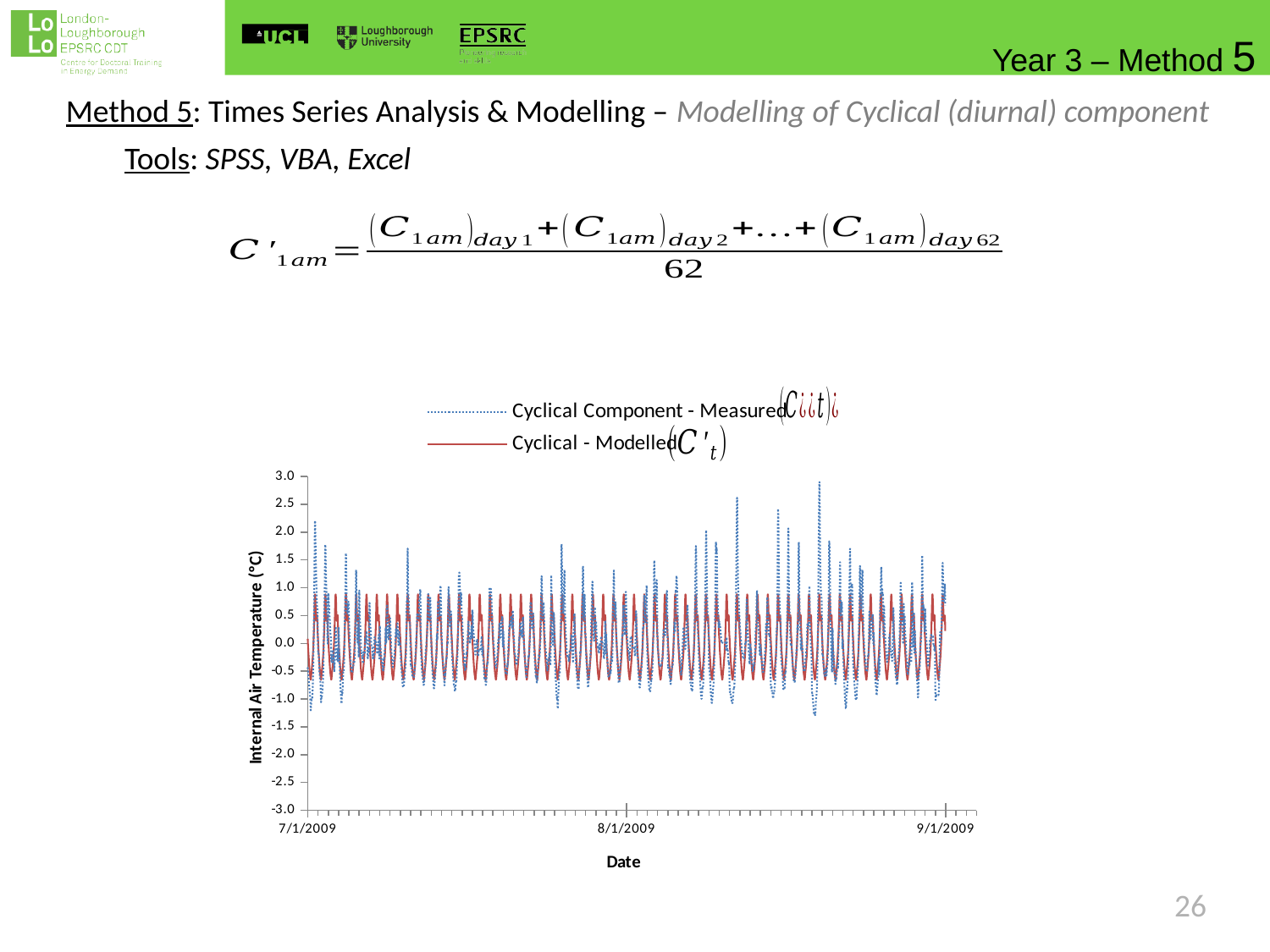
What is the first date labelled on the chart's horizontal axis? 7/1/2009 Which series in the chart is drawn as a dotted blue line? Cyclical Component - Measured What is the highest value shown on the chart's vertical axis? 3.0 What kind of chart is shown on the slide? Line chart Which series reaches higher peak values, Cyclical Component - Measured or Cyclical - Modelled? Cyclical Component - Measured Is the maximum value of the Cyclical Component - Measured series greater or less than 2.5? greater How many series does the chart's legend list? 2 How many dates are labelled on the chart's horizontal axis? 3 Is the maximum value of the Cyclical - Modelled series greater or less than 1.5? less